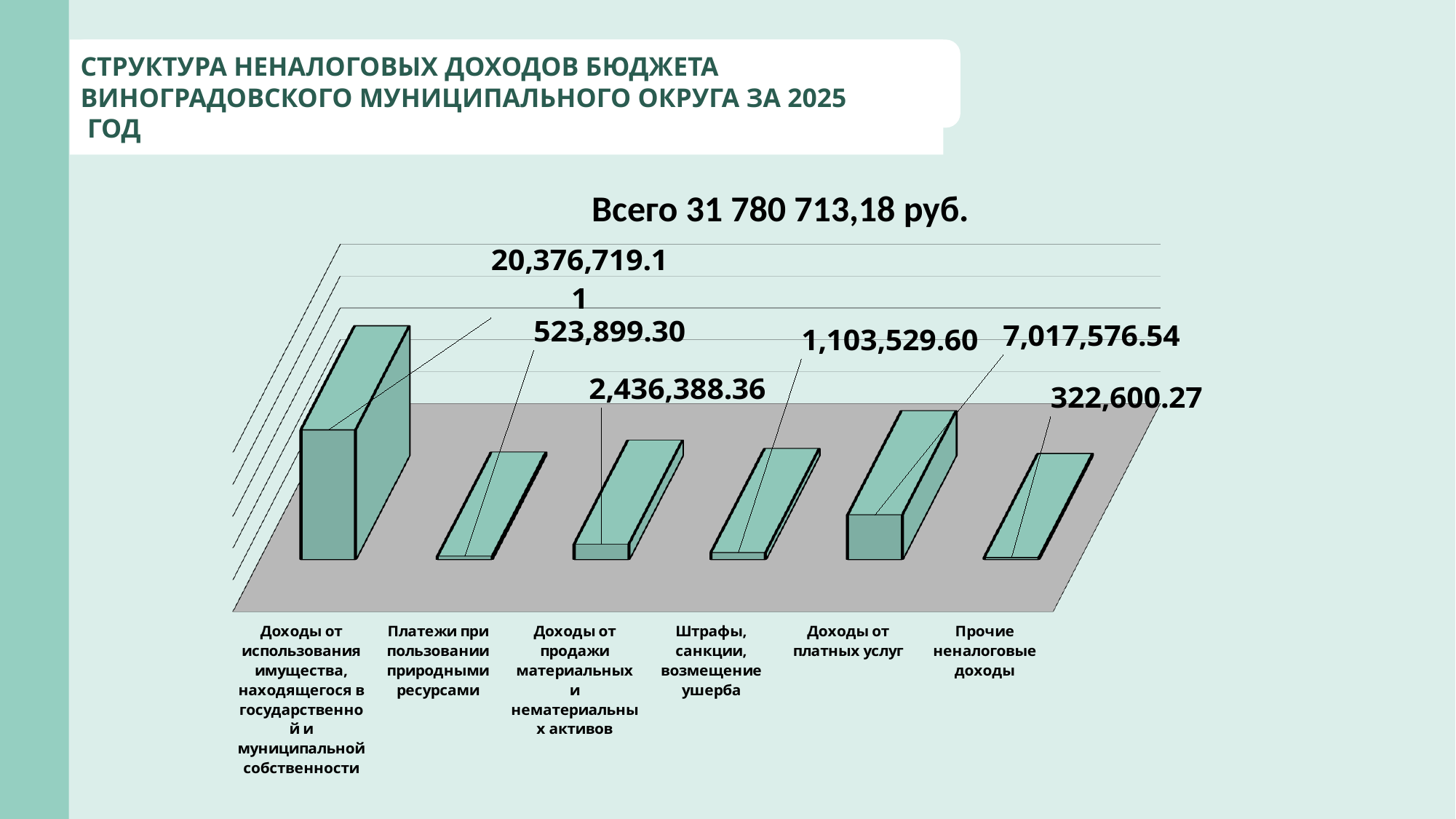
What is the value for «Платежи при пользовании природными ресурсами»? 523,899.30 Which is larger: «Доходы от платных услуг» or «Штрафы, санкции, возмещение ущерба»? Доходы от платных услуг What is the value for «Штрафы, санкции, возмещение ущерба»? 1,103,529.60 What is the difference between «Штрафы, санкции, возмещение ущерба» and «Платежи при пользовании природными ресурсами»? 579,630.30 What is the difference between «Доходы от платных услуг» and «Доходы от продажи материальных и нематериальных активов»? 4,581,188.18 What is the value for «Доходы от продажи материальных и нематериальных активов»? 2,436,388.36 How many categories are shown in the chart? 6 What is the chart title? Всего 31 780 713,18 руб. What is the value for «Доходы от платных услуг»? 7,017,576.54 What is the value for «Прочие неналоговые доходы»? 322,600.27 Which category has the highest value? Доходы от использования имущества, находящегося в государственной и муниципальной собственности Which category has the lowest value? Прочие неналоговые доходы